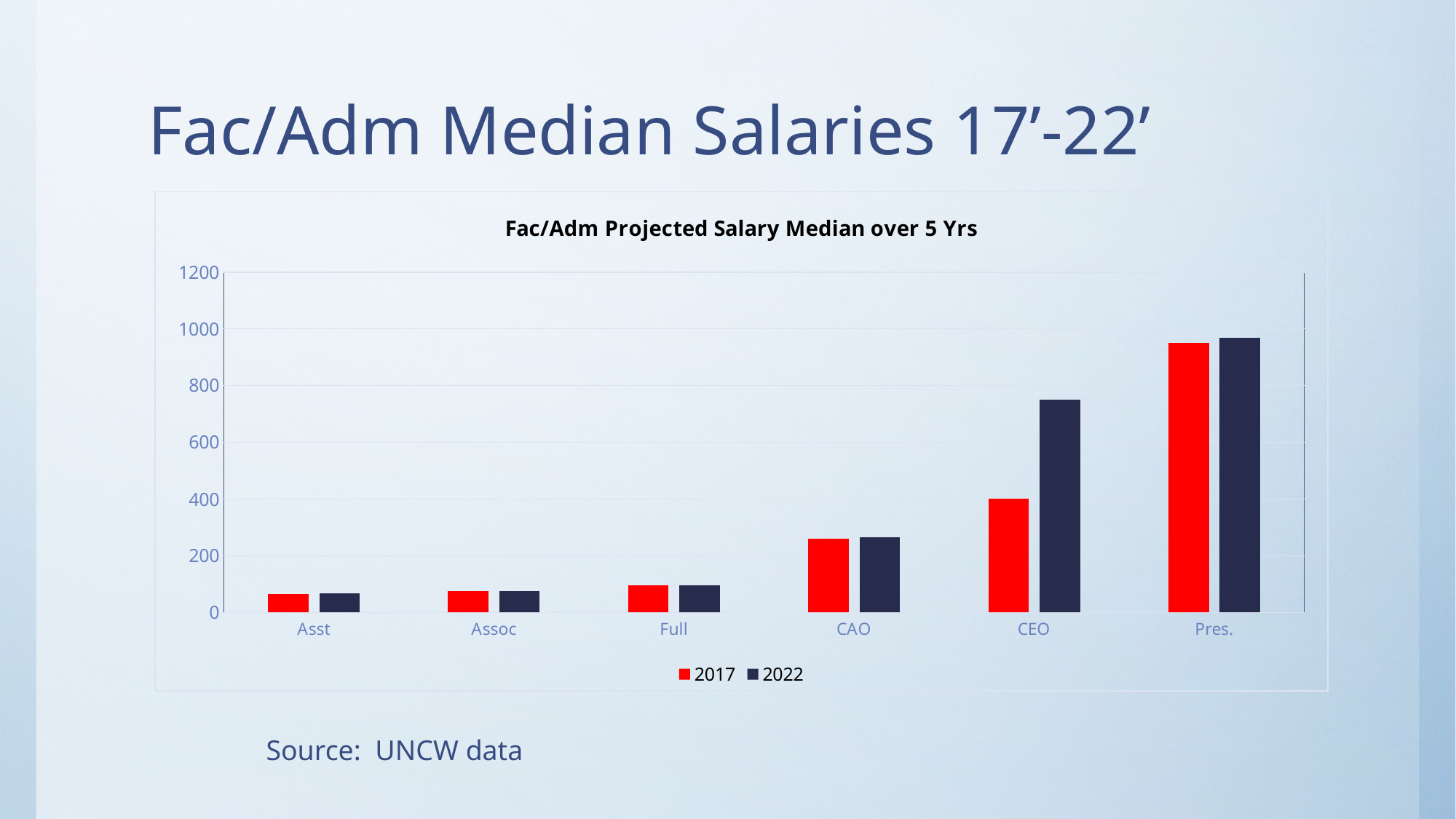
Is the 2017 value for Pres. greater or less than 1000? less Which category has the highest values in the chart? Pres. Is the 2022 value for Asst greater or less than 200? less How many categories are shown on the x axis of the chart? 6 Is the 2017 value for CAO greater or less than 200? greater Do the values generally rise or fall moving from Asst to Pres. along the x axis? rise What kind of chart is shown on the slide? bar chart Which is larger: the 2017 value for Pres. or the 2022 value for CEO? 2017 value for Pres. How many series does the chart's legend list? 2 What is the title of the chart? Fac/Adm Projected Salary Median over 5 Yrs For CEO, which series has the larger value, 2017 or 2022? 2022